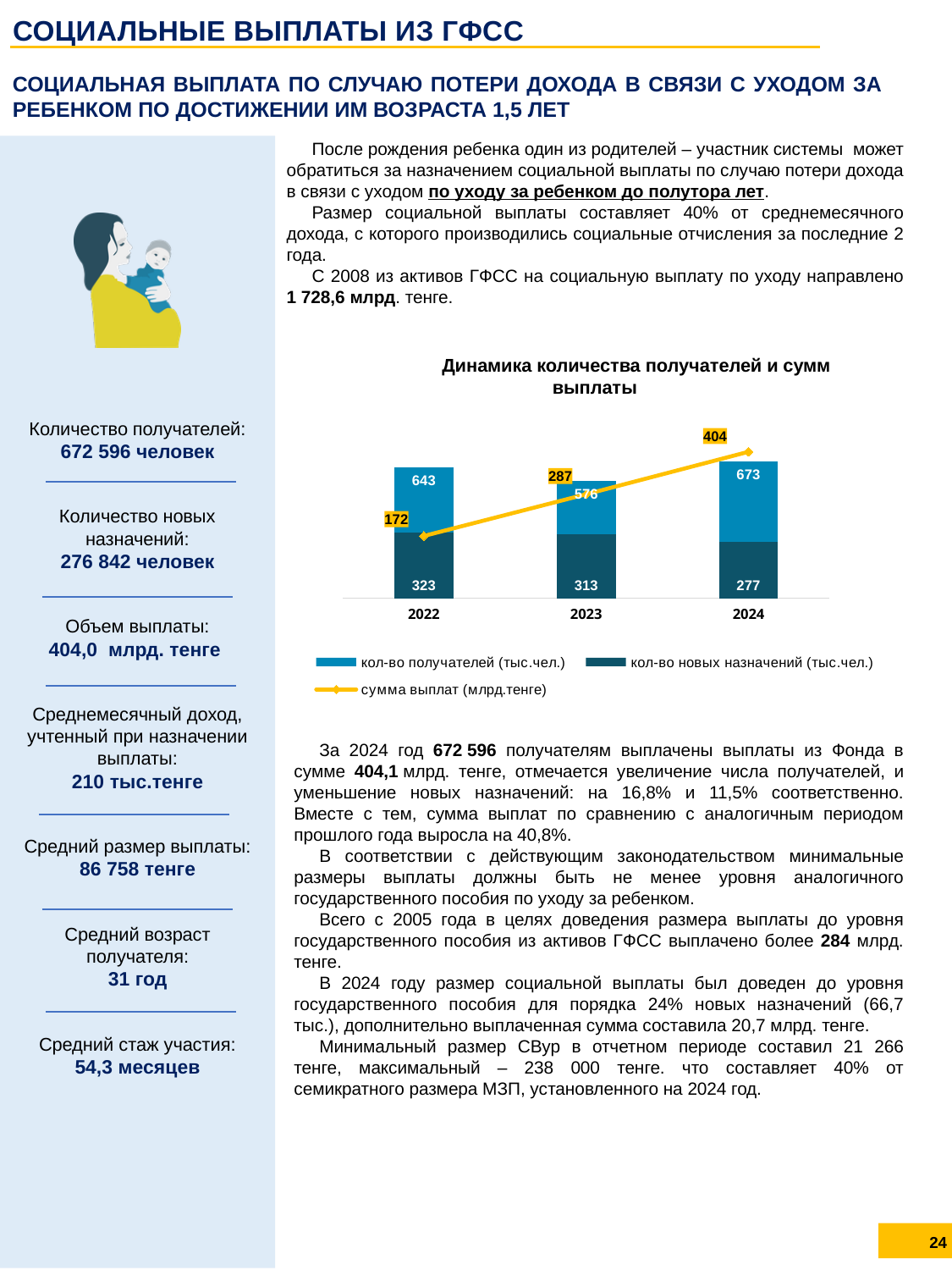
How many years are shown on the x axis of the chart? 3 What is the value for кол-во новых назначений (тыс.чел.) in 2022? 323 Does сумма выплат (млрд.тенге) rise or fall from 2022 to 2024? Rise In which year is кол-во получателей (тыс.чел.) the lowest? 2023 Which is larger: кол-во новых назначений in 2023 or in 2024? 2023 What is the total of the stacked bar for 2022 (получатели plus новые назначения)? 966 What kind of chart is used to show the data? Stacked bar chart with a line What is the value of сумма выплат (млрд.тенге) in 2023? 287 What is the difference between сумма выплат in 2024 and in 2022? 232 In which year is сумма выплат (млрд.тенге) the highest? 2024 How many series does the chart legend list? 3 What is the value for кол-во получателей (тыс.чел.) in 2024? 673